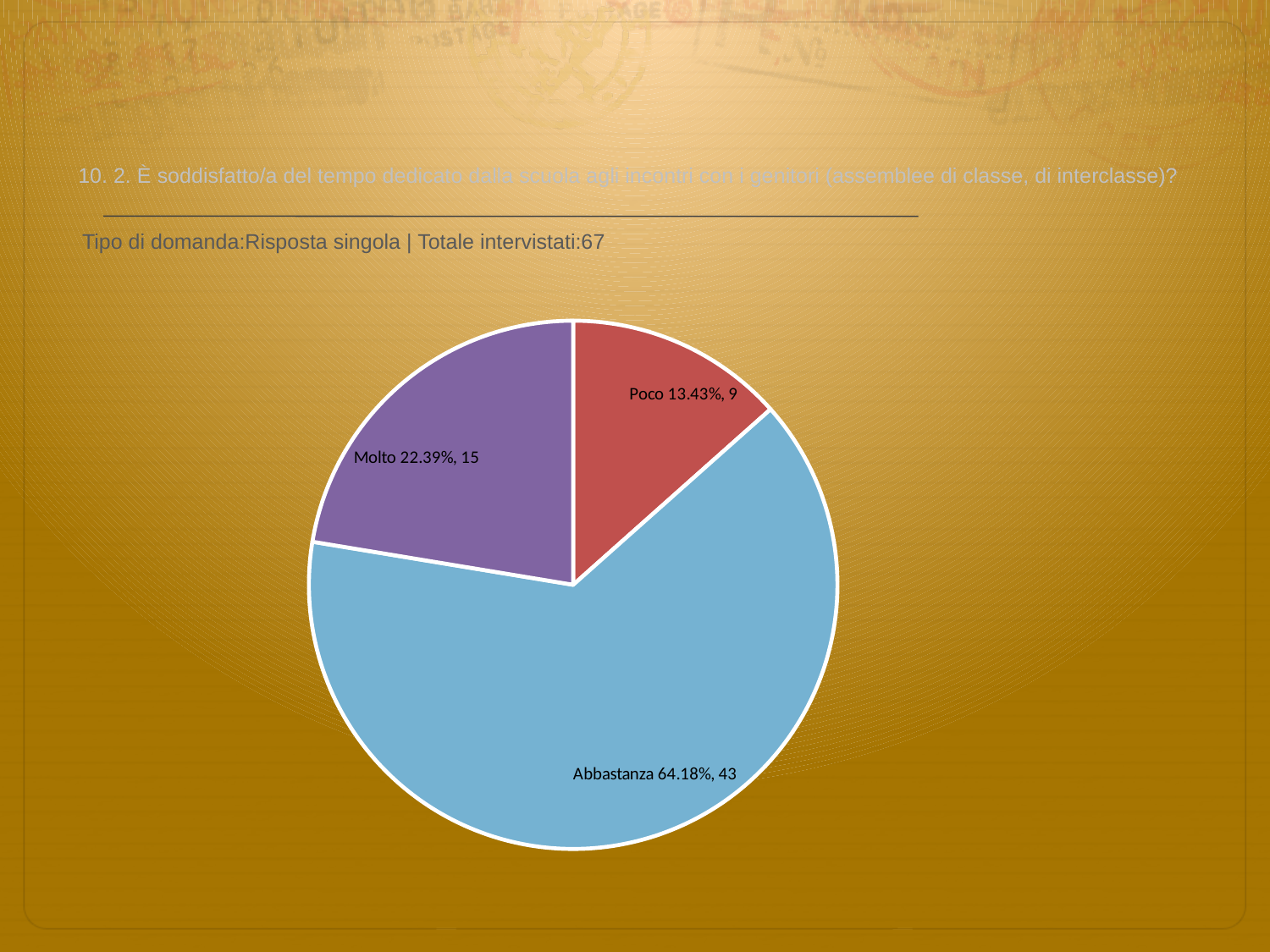
How many slices does the pie chart have? 3 What percentage share does the Molto slice have? 22.39% Which has more respondents, Molto or Poco? Molto How many respondents answered Abbastanza? 43 How many respondents answered Molto? 15 What percentage share does the Poco slice have? 13.43% What percentage share does the Abbastanza slice have? 64.18% Which category has the smallest slice? Poco Which category has the largest slice? Abbastanza How many respondents answered Poco? 9 What is the difference in respondent count between Molto and Poco? 6 What kind of chart is shown on the slide? pie chart